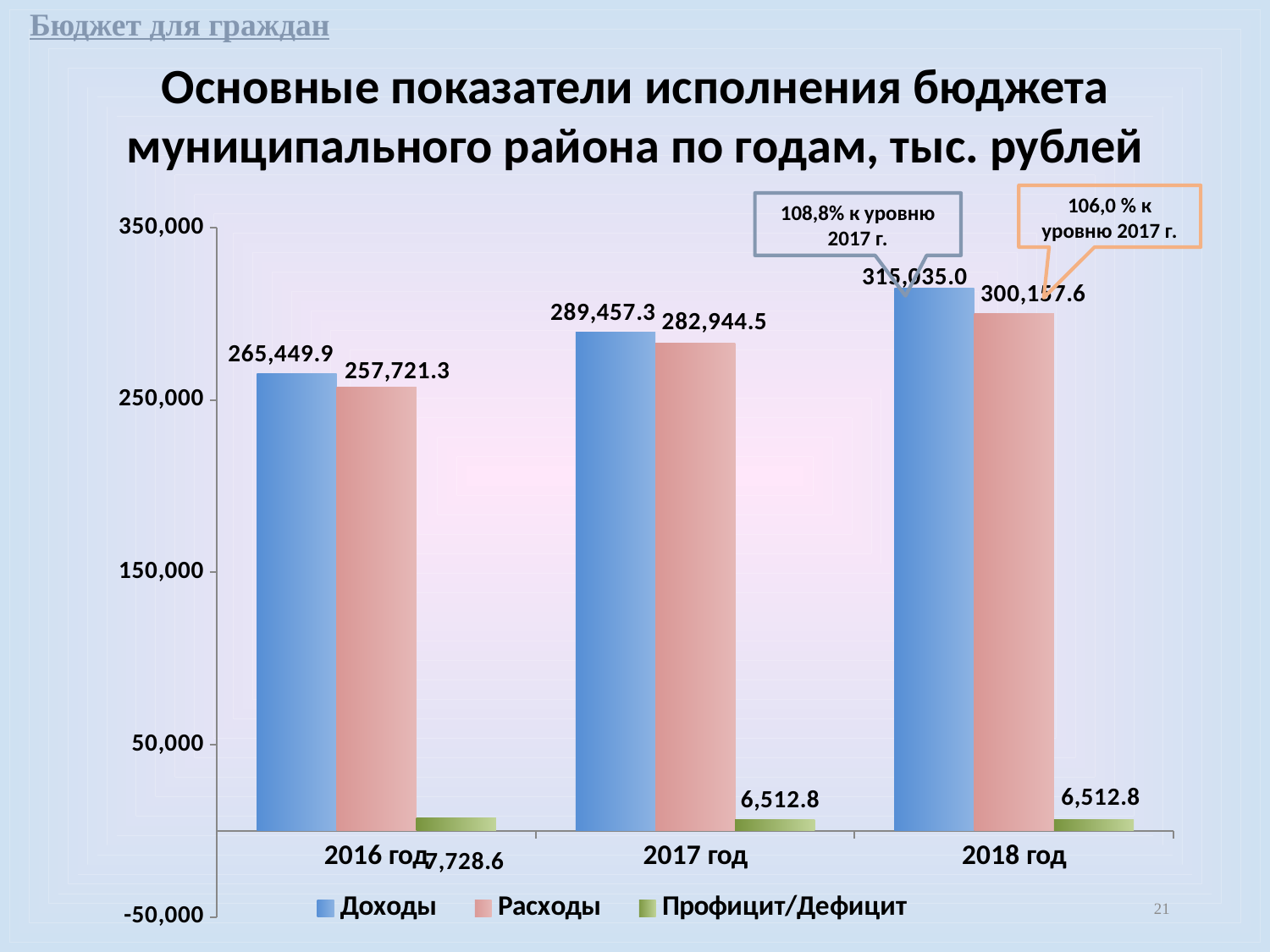
What is the value of Профицит/Дефицит for 2017 год? 6,512.8 Which is larger for 2016 год, Доходы or Расходы? Доходы Do the Доходы values rise or fall from 2016 год to 2018 год? rise What kind of chart is shown on the slide? bar chart How many series does the legend list? 3 How many year categories are shown on the x axis? 3 What is the value of Расходы for 2017 год? 282,944.5 What is the value of Доходы for 2016 год? 265,449.9 In which year is Доходы the highest? 2018 год What is the difference between Доходы and Расходы for 2017 год? 6,512.8 What is the value of Расходы for 2016 год? 257,721.3 Is the value of Расходы for 2018 год greater or less than 250,000? greater